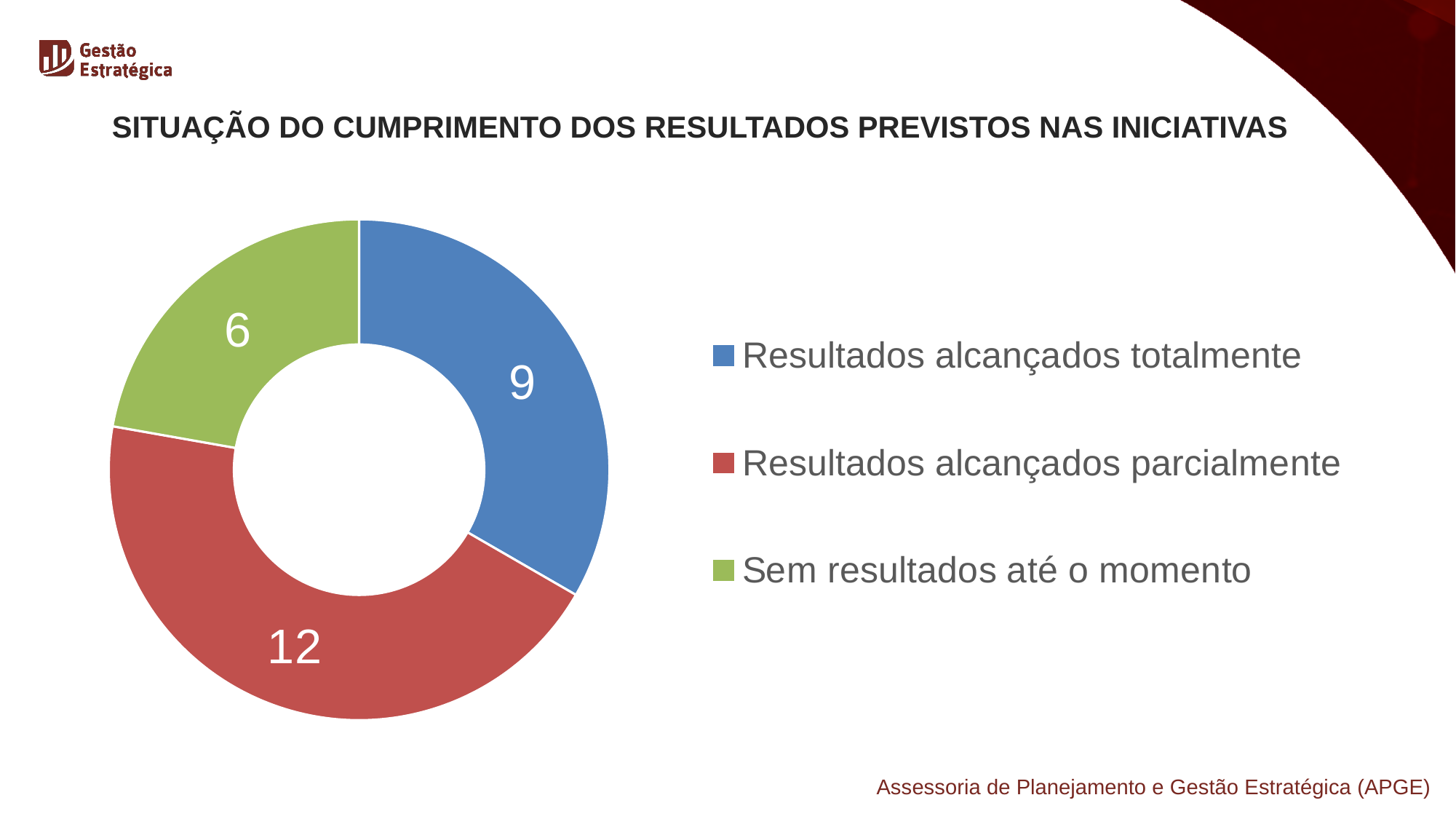
Which is larger: "Resultados alcançados totalmente" or "Sem resultados até o momento"? Resultados alcançados totalmente What share of the total does "Sem resultados até o momento" represent? 6 of 27 What kind of chart is shown on the slide? Doughnut (pie) chart How many categories does the chart show? 3 What is the total of all the slices in the chart? 27 What colour represents "Resultados alcançados parcialmente" in the legend? Red What value is shown for "Resultados alcançados totalmente"? 9 What value is shown for "Resultados alcançados parcialmente"? 12 Which category has the smallest slice? Sem resultados até o momento What is the difference between the values for "Resultados alcançados parcialmente" and "Resultados alcançados totalmente"? 3 Which category has the largest slice? Resultados alcançados parcialmente What value is shown for "Sem resultados até o momento"? 6